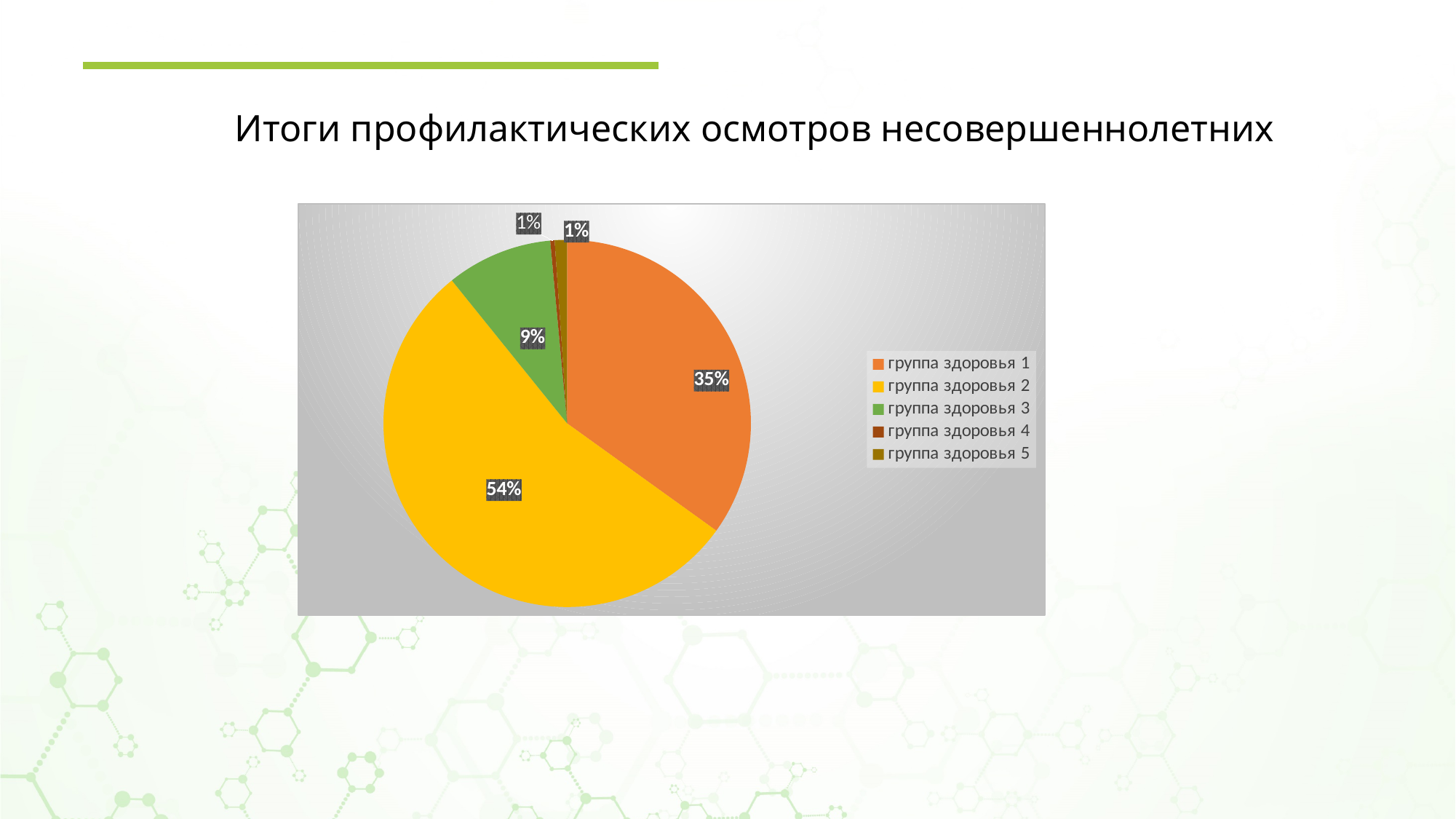
Which is larger, the share of группа здоровья 1 or группа здоровья 3? группа здоровья 1 What is the value shown for группа здоровья 1? 35% What is the title of the slide above the chart? Итоги профилактических осмотров несовершеннолетних What share of the pie does группа здоровья 2 represent? 54% What type of chart is shown on the slide? pie chart How many slices does the pie chart have? 5 What is the value shown for группа здоровья 5? 1% What is the value shown for группа здоровья 4? 1% What is the value shown for группа здоровья 3? 9% How many entries does the legend list? 5 Which category has the largest slice of the pie? группа здоровья 2 What is the difference between the shares of группа здоровья 2 and группа здоровья 1? 19%